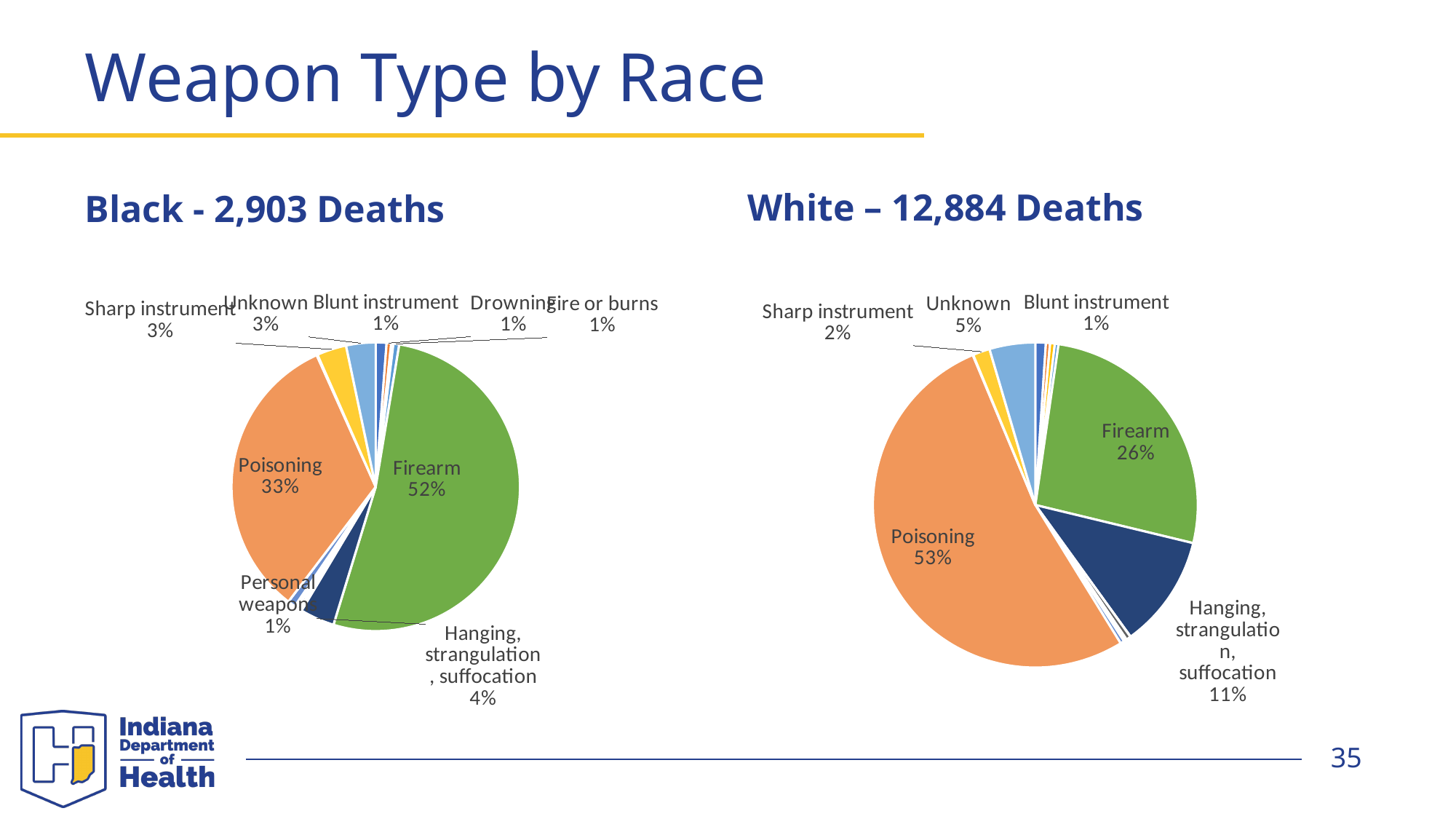
Which chart shows a larger Firearm share, Black - 2,903 Deaths or White – 12,884 Deaths? Black - 2,903 Deaths In the White – 12,884 Deaths chart, which is larger, the Unknown share or the Sharp instrument share? Unknown In the White – 12,884 Deaths chart, which weapon type has the largest share? Poisoning In the Black - 2,903 Deaths chart, how many weapon type categories are labelled? 9 In the White – 12,884 Deaths chart, what is the difference between the Poisoning share and the Firearm share? 27% In the Black - 2,903 Deaths chart, what percentage is shown for Unknown? 3% In the Black - 2,903 Deaths chart, what is the difference between the Firearm share and the Poisoning share? 19% In the White – 12,884 Deaths chart, what percentage is shown for Hanging, strangulation, suffocation? 11% In the Black - 2,903 Deaths chart, which weapon type has the largest share? Firearm What type of chart is used on this slide? Pie chart In the White – 12,884 Deaths chart, what share of deaths is attributed to Poisoning? 53% In the Black - 2,903 Deaths chart, what share of deaths is attributed to Firearm? 52%